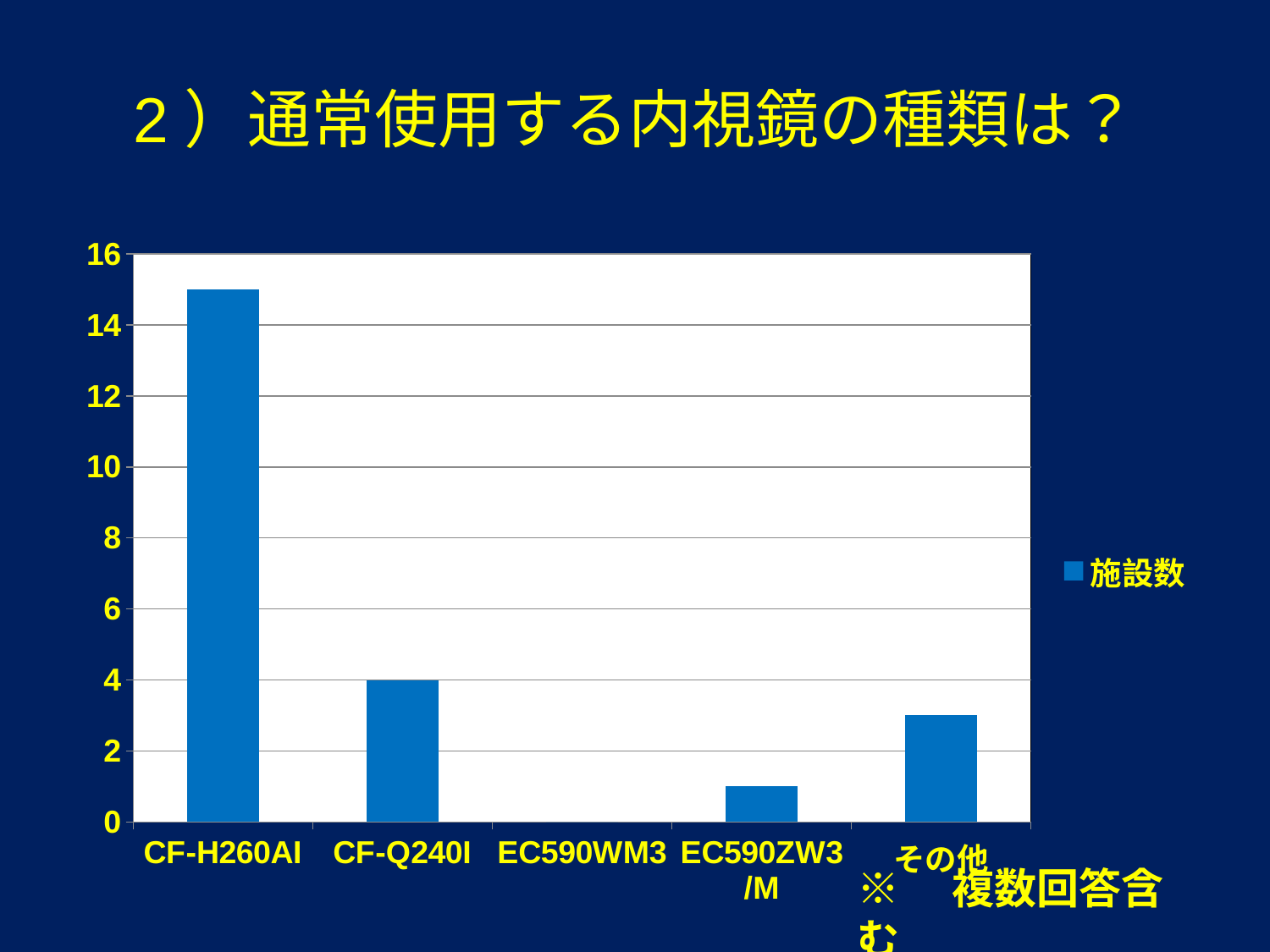
Is the value for その他 greater or less than 2? greater Which category has the highest value? CF-H260AI How many series does the legend list? 1 What is the value for CF-Q240I? 4 Which is larger, the value for CF-Q240I or the value for その他? CF-Q240I Is the value for EC590ZW3/M greater or less than 2? less Which category has the lowest value? EC590WM3 What is the name of the series shown in the legend? 施設数 How many categories are shown on the x axis of the chart? 5 Is the value for CF-H260AI greater or less than 14? greater What is the value for EC590WM3? 0 What type of chart is shown on the slide? bar chart